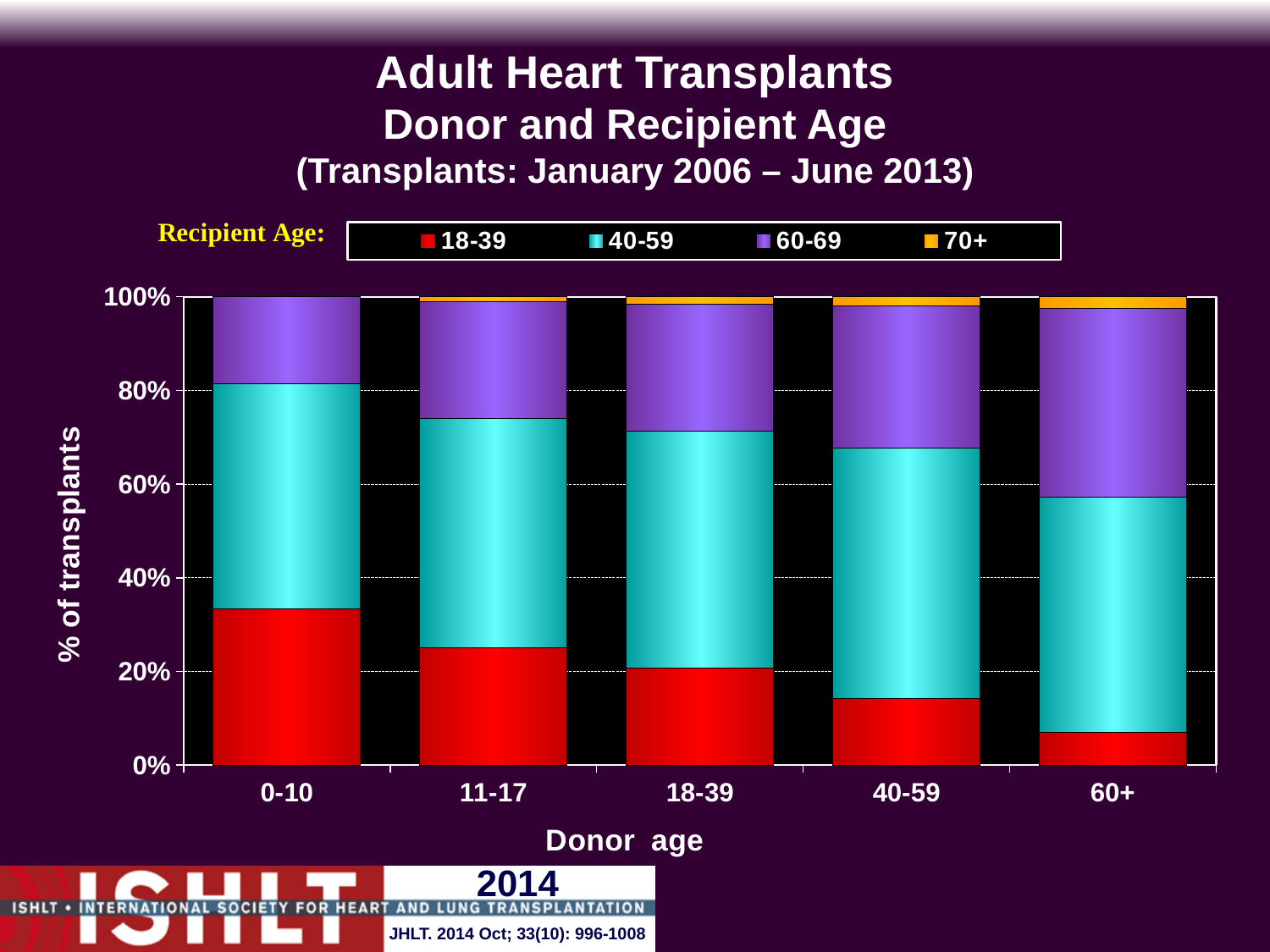
What is the label of the y axis? % of transplants Which donor age group has the smallest share of 18-39 recipients? 60+ Which donor age group has a larger share of 18-39 recipients, 0-10 or 11-17? 0-10 Which donor age group has the largest share of 60-69 recipients? 60+ Is the share of 18-39 recipients for donor age 0-10 greater or less than 20%? greater What kind of chart is shown on the slide? Stacked bar chart Is the share of 60-69 recipients for donor age 60+ greater or less than 20%? greater As donor age increases along the x axis, does the share of 18-39 recipients rise or fall? fall How many recipient age groups does the legend list? 4 Which donor age group has the largest share of 18-39 recipients? 0-10 How many donor age categories are shown on the x axis? 5 Is the share of 18-39 recipients for donor age 60+ greater or less than 20%? less